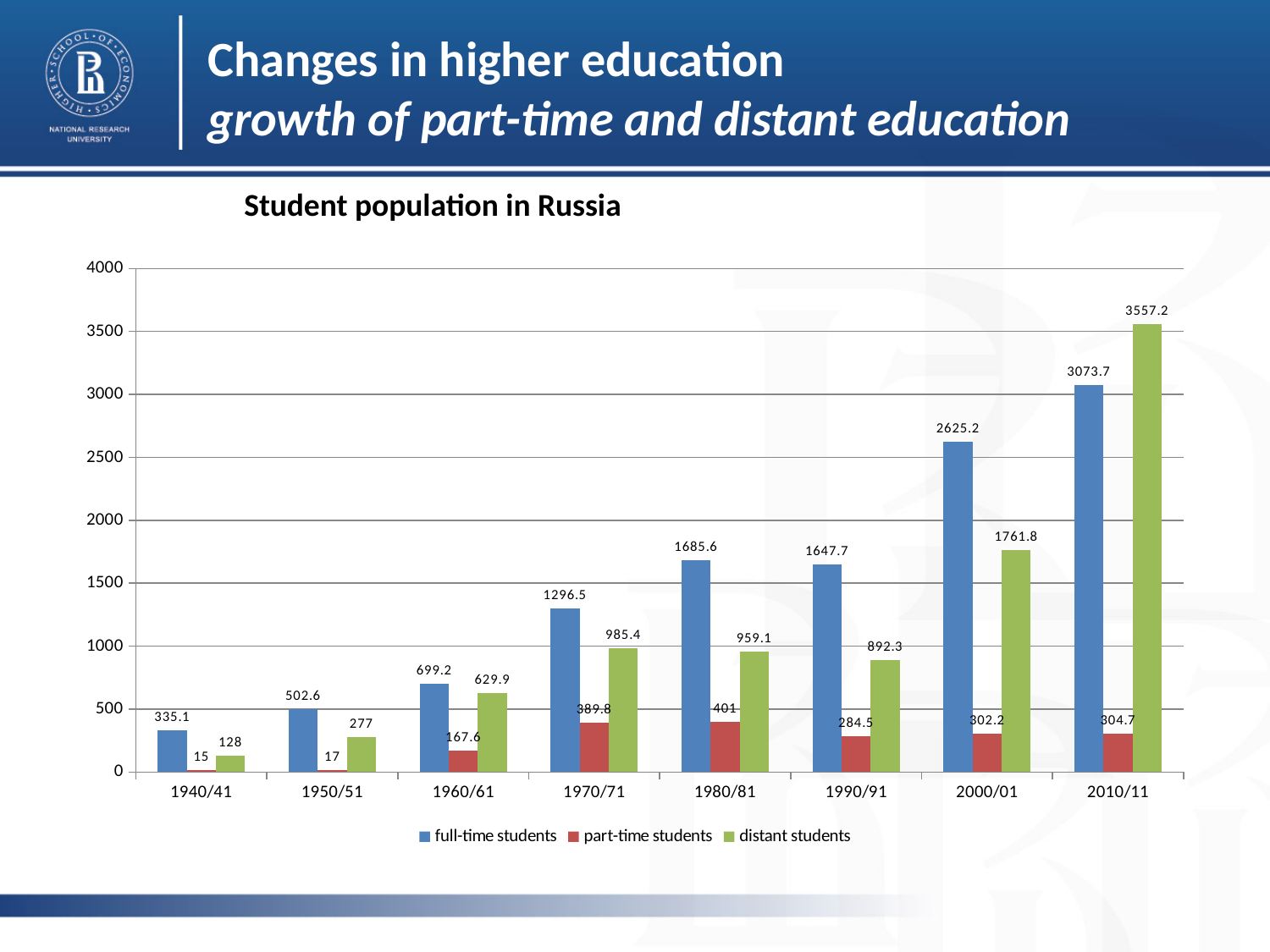
How many series does the legend list? 3 Is the value for full-time students in 1980/81 greater or less than 1500? greater What kind of chart is shown? bar chart Which year has the highest value for distant students? 2010/11 What is the title of the chart? Student population in Russia What is the value for distant students in 1970/71? 985.4 What is the value for part-time students in 1940/41? 15 Which year has the lowest value for full-time students? 1940/41 How many years are shown on the x axis? 8 What is the value for full-time students in 2010/11? 3073.7 Which is larger in 2010/11, full-time students or distant students? distant students What is the difference between full-time students and distant students in 2000/01? 863.4